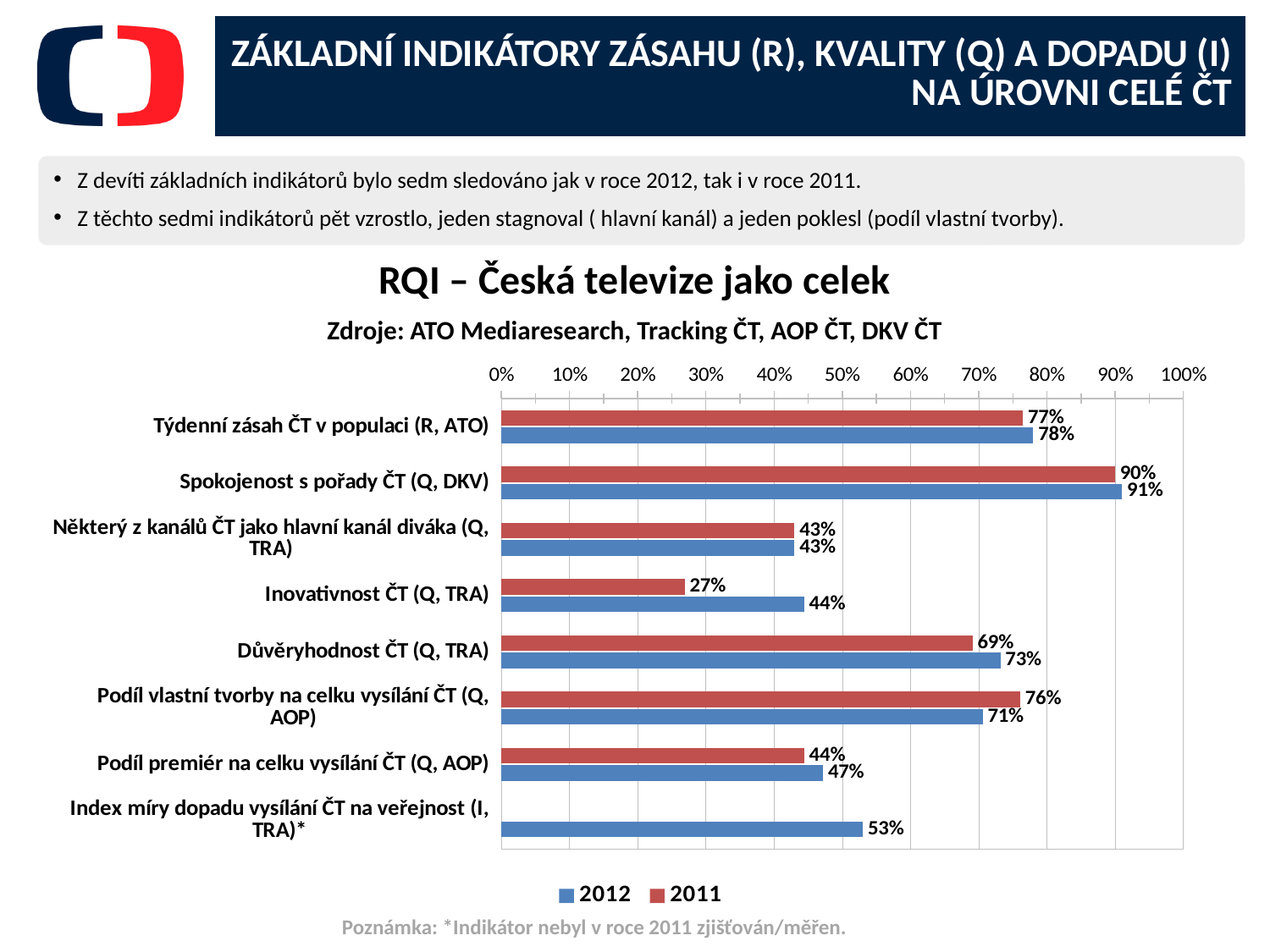
What kind of chart is shown on the slide? Bar chart How many series does the legend list? 2 For Podíl vlastní tvorby na celku vysílání ČT (Q, AOP), which year has the larger value, 2012 or 2011? 2011 Which colour represents the 2011 series in the chart? Red Which category has the lowest 2011 value? Inovativnost ČT (Q, TRA) Which category has the highest 2012 value? Spokojenost s pořady ČT (Q, DKV) What is the 2012 value for Spokojenost s pořady ČT (Q, DKV)? 91% How many categories are shown on the chart? 8 What is the 2012 value for Index míry dopadu vysílání ČT na veřejnost (I, TRA)*? 53% What is the difference between the 2012 and 2011 values for Inovativnost ČT (Q, TRA)? 17% What is the title of the chart? RQI – Česká televize jako celek What is the 2011 value for Inovativnost ČT (Q, TRA)? 27%